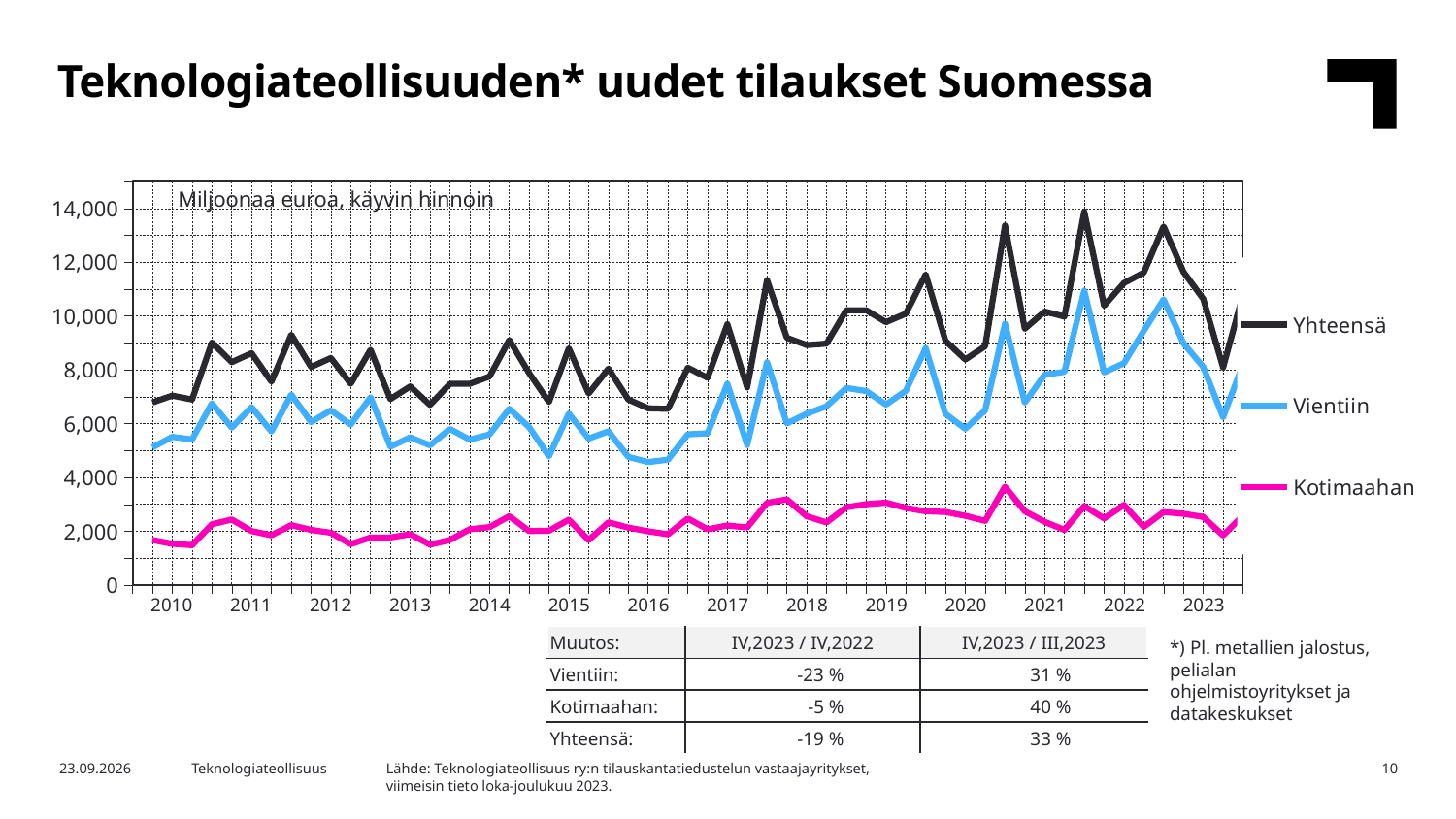
What are the three series named in the chart legend? Yhteensä, Vientiin, Kotimaahan How many years are labelled on the x axis of the chart? 14 Is the value for Kotimaahan in 2010 greater or less than 4,000? less What kind of chart is shown on the slide? line chart Which series has the lowest values throughout the chart? Kotimaahan How many series does the chart's legend list? 3 What is the highest value shown on the chart's y axis? 14,000 What unit label is printed inside the chart area? Miljoonaa euroa, käyvin hinnoin Which series has the highest values throughout the chart? Yhteensä Is the value for Vientiin at the start of 2010 greater or less than 6,000? less Is the peak value for Yhteensä in 2021 greater or less than 12,000? greater Which is larger in 2020, the value for Yhteensä or the value for Kotimaahan? Yhteensä